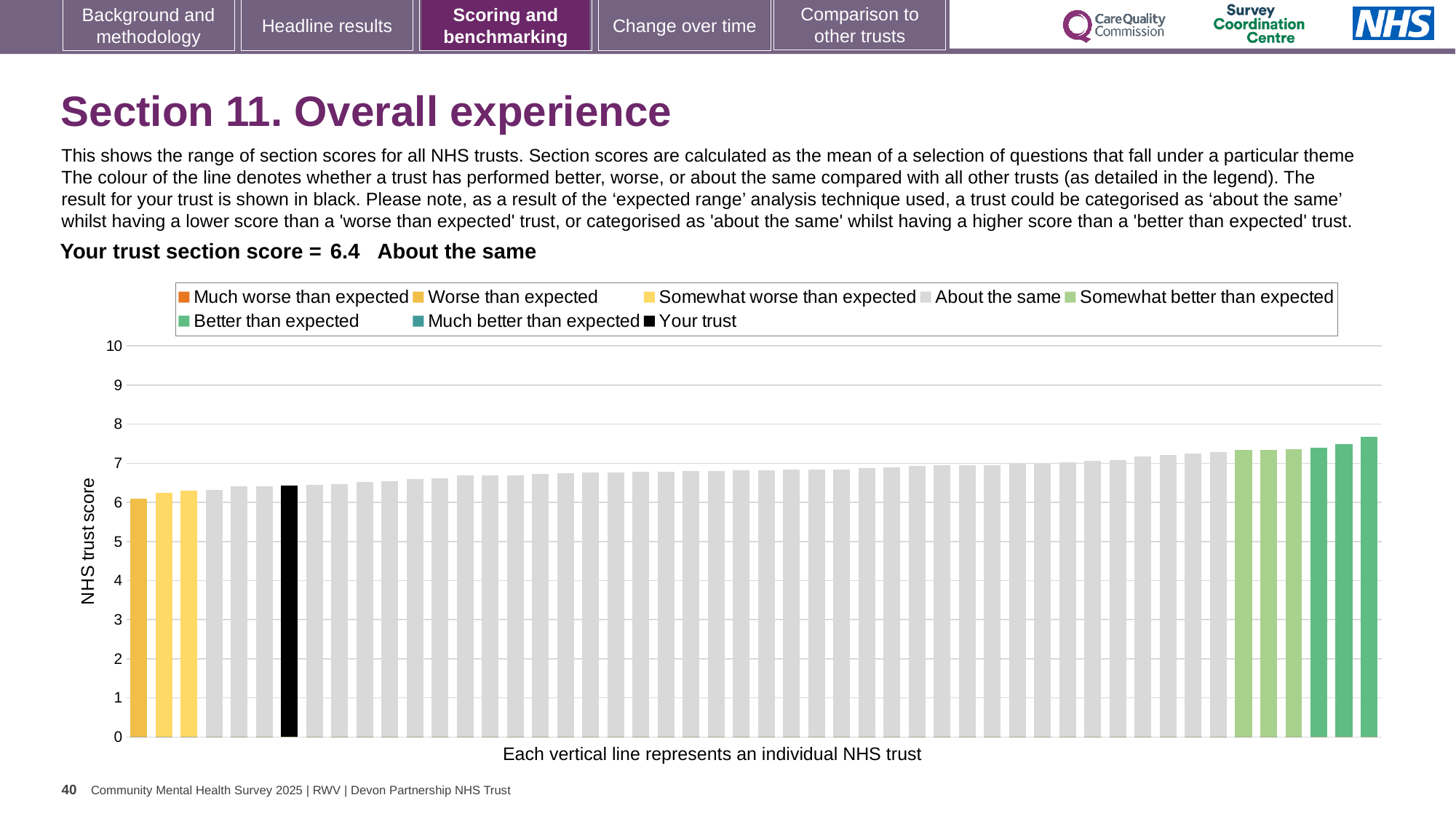
Is the value for your trust (the black bar) greater or less than 5? greater What colour is the bar representing your trust? Black What kind of chart is shown on the slide? Bar chart Is the value of the shortest bar (leftmost) greater or less than 7? less Is the value for your trust (the black bar) greater or less than 7? less What is the label on the vertical axis of the chart? NHS trust score How many entries does the chart legend list? 8 What is the section score for your trust shown on the slide? 6.4 Which category is your trust placed in according to the text above the chart? About the same Do the bar values rise or fall from left to right along the x axis? Rise